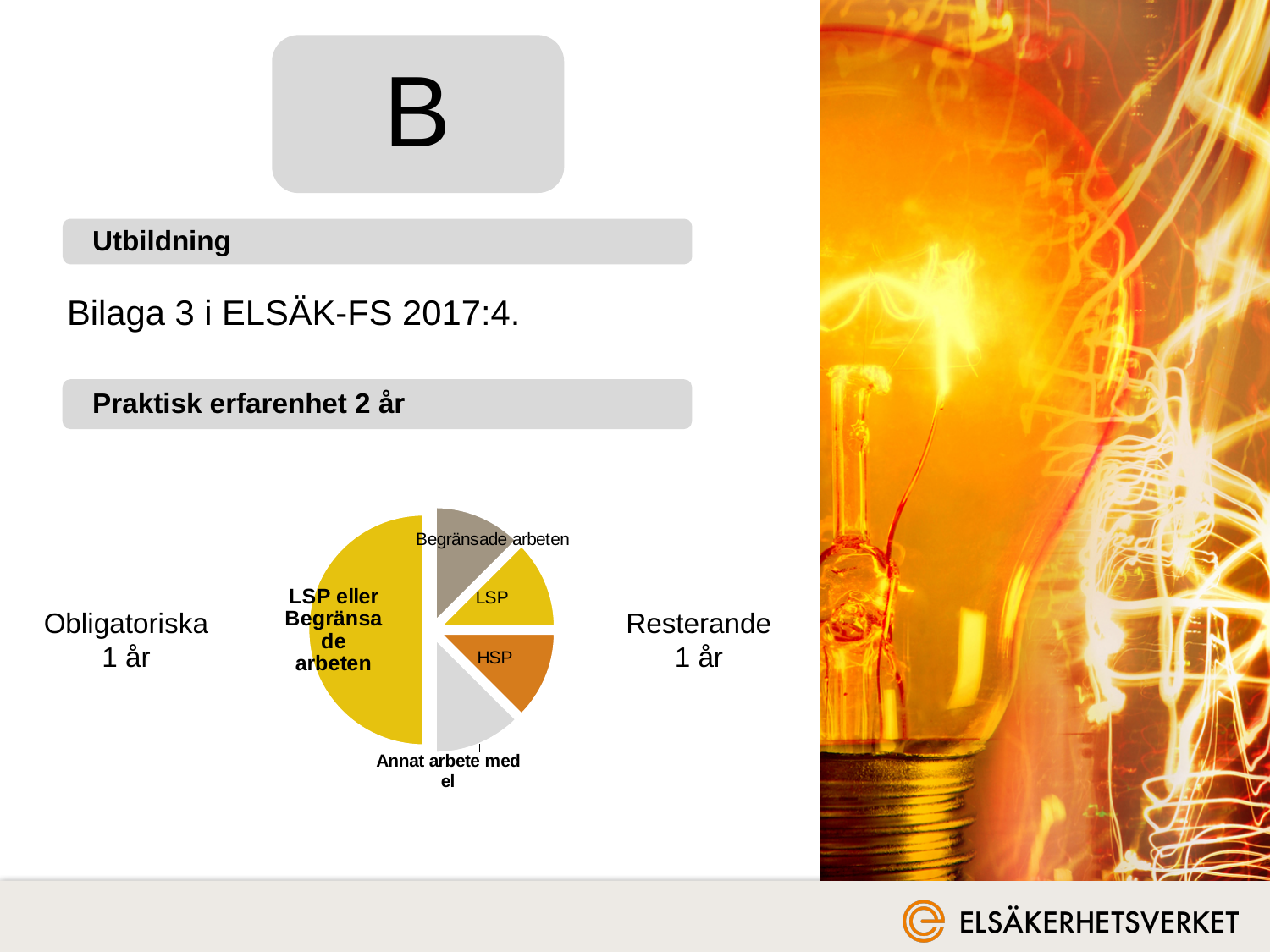
Which slice of the pie chart is the largest? LSP eller Begränsade arbeten Which slice is larger in the pie chart, "LSP eller Begränsade arbeten" or "Annat arbete med el"? LSP eller Begränsade arbeten What kind of chart is shown on the slide? pie chart What label is shown on the slice at the bottom of the pie chart? Annat arbete med el How many slices does the pie chart have? 5 What colour is the "HSP" slice in the pie chart? orange Which slice is larger in the pie chart, "LSP eller Begränsade arbeten" or "HSP"? LSP eller Begränsade arbeten